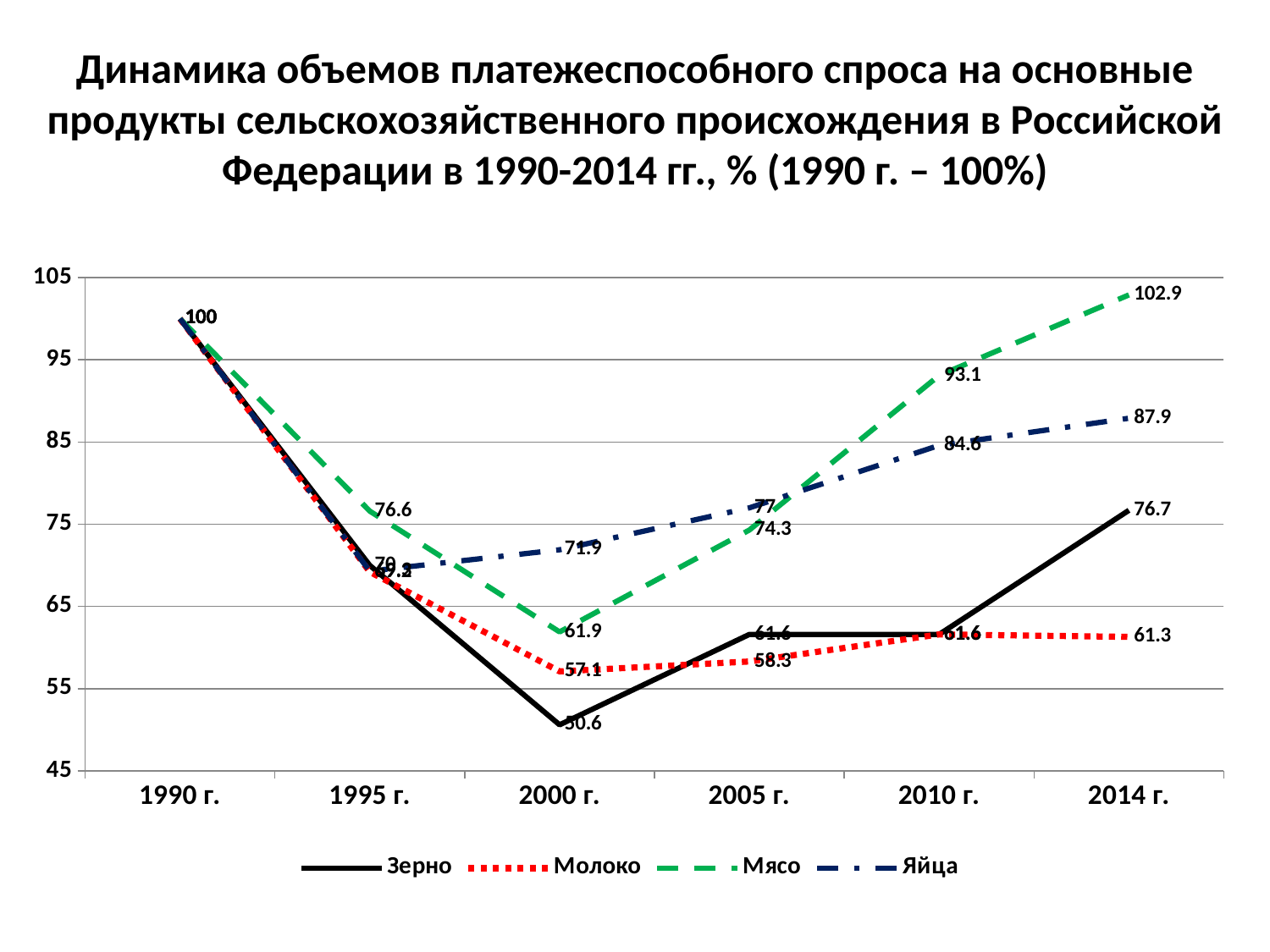
What is the value for Яйца in 2014 г.? 87.9 Which is larger in 2005 г., the value for Яйца or the value for Мясо? Яйца Which series has the lowest value in 2000 г.? Зерно Does the value for Мясо rise or fall from 2000 г. to 2014 г.? rise How many years are shown on the x axis? 6 What is the value for Зерно in 2000 г.? 50.6 What kind of chart is shown on the slide? line chart How many series does the legend list? 4 What is the value for Мясо in 2014 г.? 102.9 Which series has the highest value in 2014 г.? Мясо What is the value for Молоко in 2014 г.? 61.3 What is the difference between the values for Мясо and Зерно in 2014 г.? 26.2